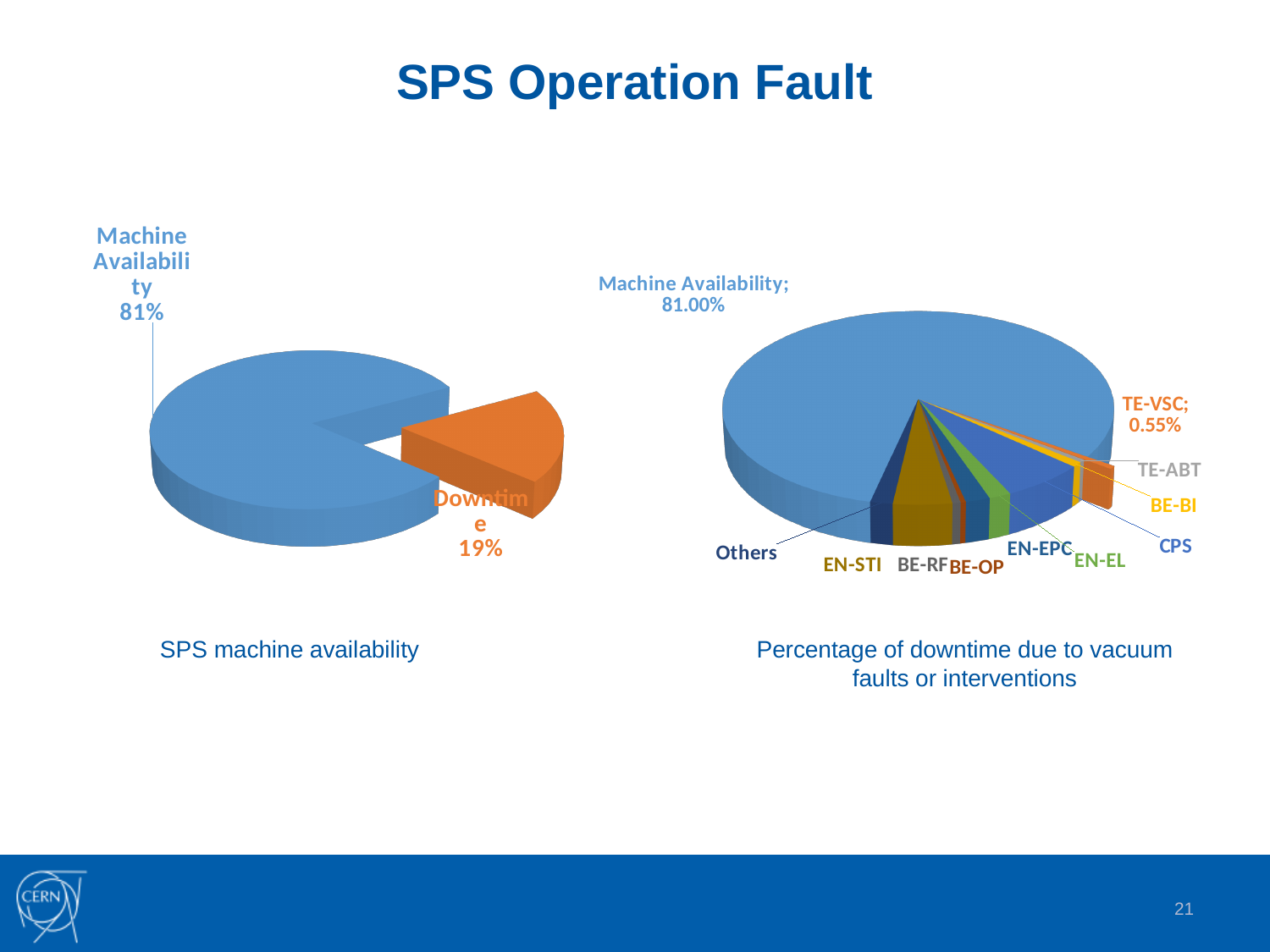
In the right chart (Percentage of downtime due to vacuum faults or interventions), how many slices are labelled in the pie? 11 In the right chart (Percentage of downtime due to vacuum faults or interventions), what value is labelled for TE-VSC? 0.55% In the left chart (SPS machine availability), which slice is the largest? Machine Availability In the left chart (SPS machine availability), which slice is the smallest? Downtime In the left chart (SPS machine availability), by how many percentage points does Machine Availability exceed Downtime? 62 percentage points In the right chart (Percentage of downtime due to vacuum faults or interventions), what value is labelled for Machine Availability? 81.00% In the left chart (SPS machine availability), what percentage is shown for Downtime? 19% In the right chart (Percentage of downtime due to vacuum faults or interventions), which slice is the largest? Machine Availability In the right chart (Percentage of downtime due to vacuum faults or interventions), which is larger: the Machine Availability slice or the TE-VSC slice? Machine Availability What kind of chart is the left chart (SPS machine availability)? Pie chart In the left chart (SPS machine availability), how many slices does the pie have? 2 In the left chart (SPS machine availability), what percentage is shown for Machine Availability? 81%